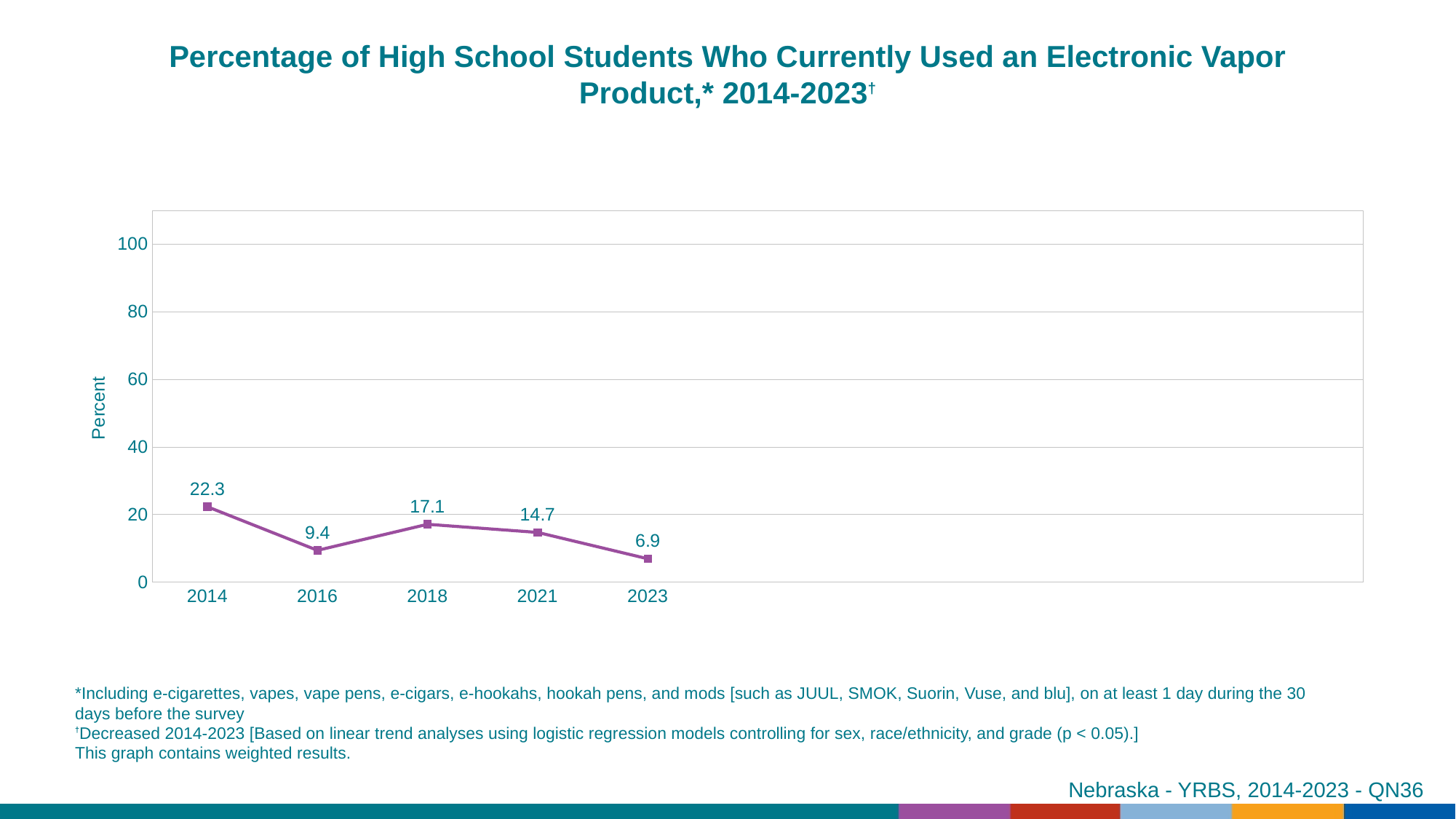
What kind of chart is shown on the slide? line chart What is the label on the y axis? Percent What is the value plotted for 2023? 6.9 What percentage of high school students currently used an electronic vapor product in 2014? 22.3 What is the difference between the 2014 value and the 2016 value? 12.9 Which year has the highest percentage? 2014 Is the value for 2014 greater or less than 20? greater Which is larger, the value for 2016 or the value for 2021? 2021 Which year has the lowest percentage? 2023 How many years are plotted on the chart? 5 What is the difference between the 2018 value and the 2021 value? 2.4 What is the value plotted for 2018? 17.1